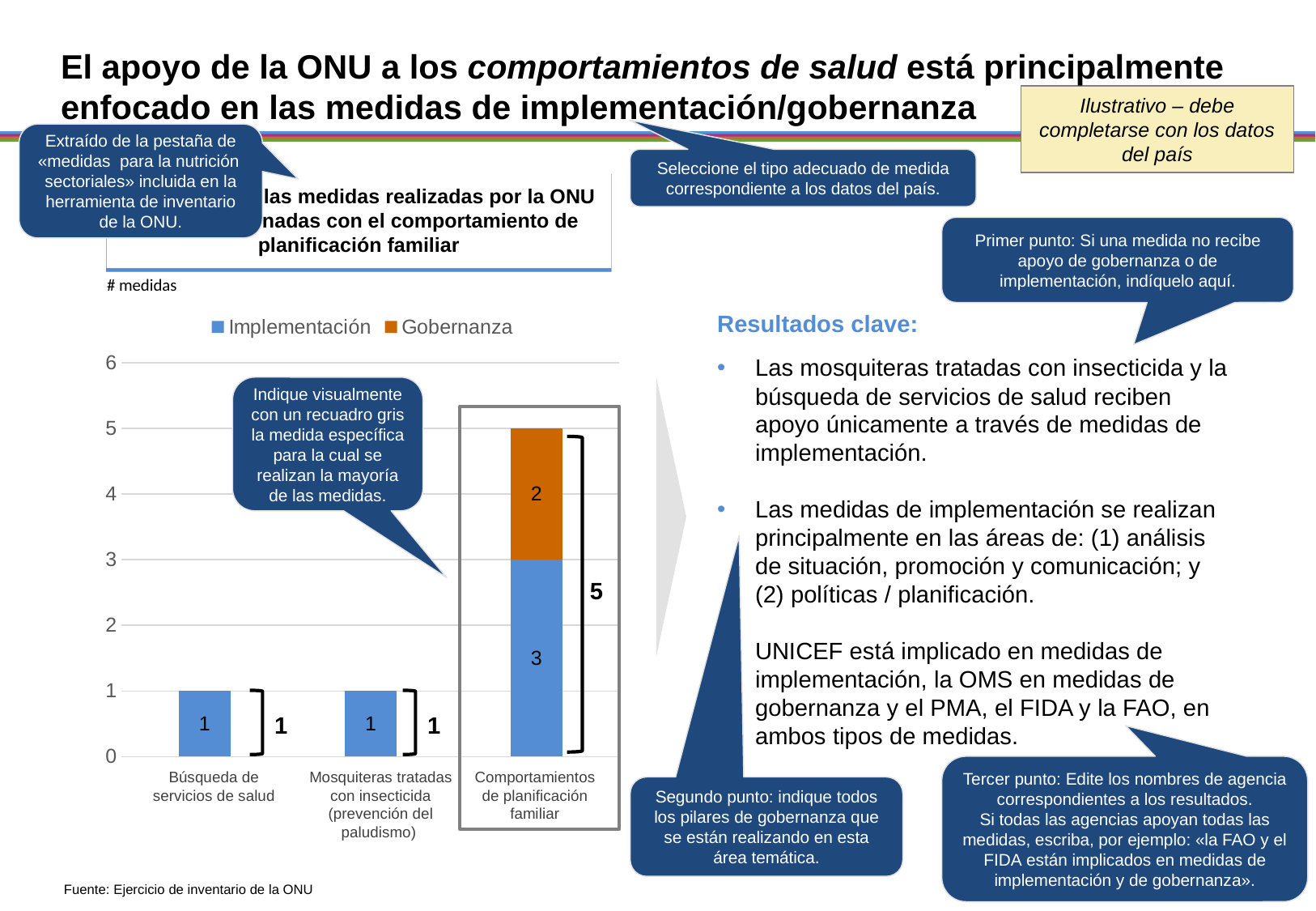
What is the Implementación value for Comportamientos de planificación familiar? 3 What is the Implementación value for Búsqueda de servicios de salud? 1 Which is larger: the total for Comportamientos de planificación familiar or the total for Mosquiteras tratadas con insecticida? Comportamientos de planificación familiar Which series are listed in the chart legend? Implementación and Gobernanza What is the total number of measures for Comportamientos de planificación familiar? 5 What is the Gobernanza value for Comportamientos de planificación familiar? 2 What is the difference between the Implementación and Gobernanza values for Comportamientos de planificación familiar? 1 What colour represents the Gobernanza series in the chart? Orange What type of chart is shown on the slide? Stacked bar chart Which category has the highest total number of measures? Comportamientos de planificación familiar How many series does the chart legend list? 2 How many categories are shown on the x axis of the chart? 3